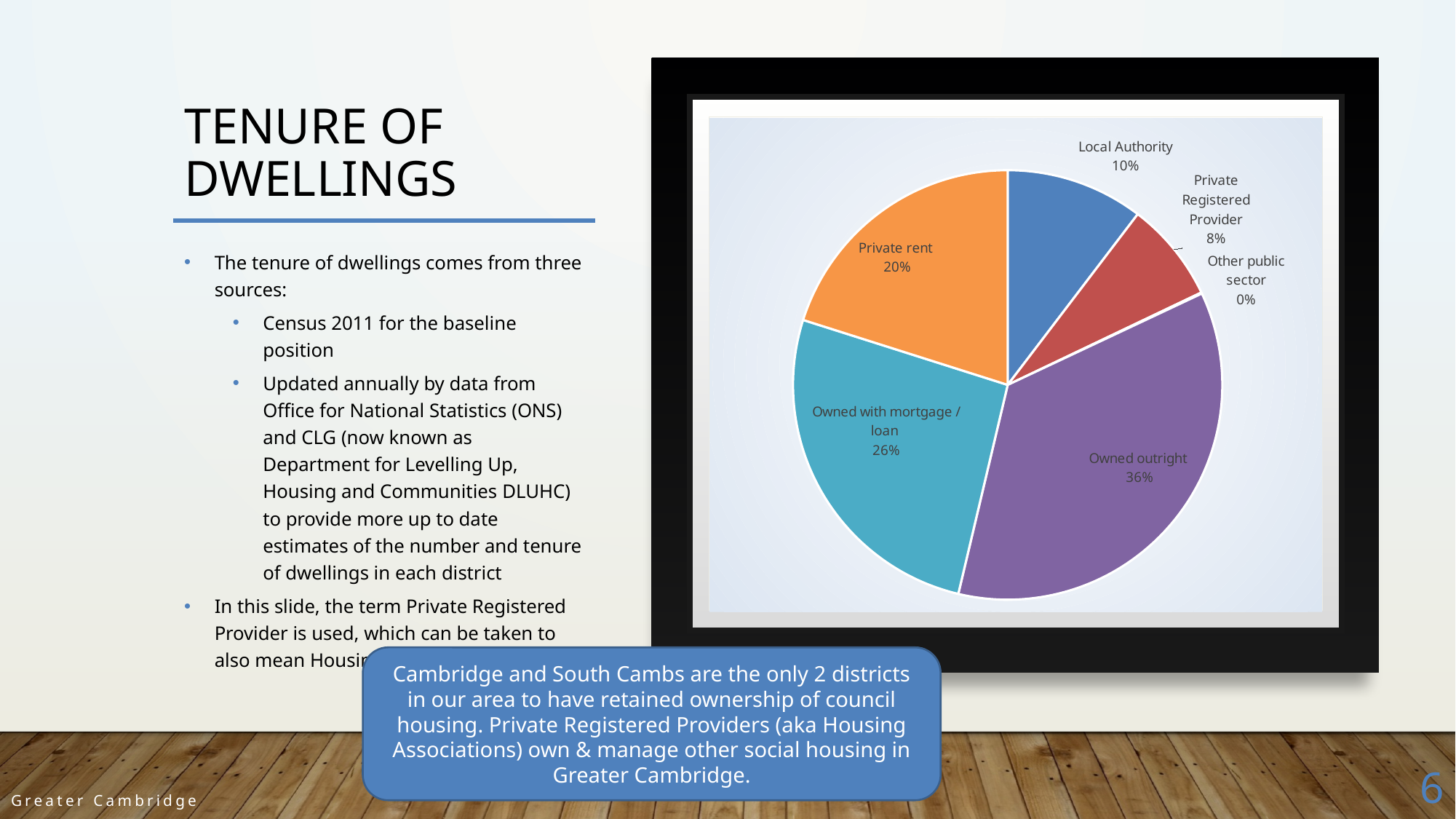
What share is shown for Other public sector? 0% What percentage of dwellings is Private rent? 20% What share is shown for Local Authority? 10% What colour is the Owned with mortgage / loan slice? Teal What is the difference in percentage points between Owned outright and Owned with mortgage / loan? 10 How many tenure categories are shown in the pie chart? 6 Which tenure category has the smallest share of the pie? Other public sector What percentage is shown for Private Registered Provider? 8% Which tenure category has the largest share of the pie? Owned outright What share of dwellings is Owned outright? 36% What type of chart is shown on the slide? Pie chart Which is larger, Private rent or Local Authority? Private rent